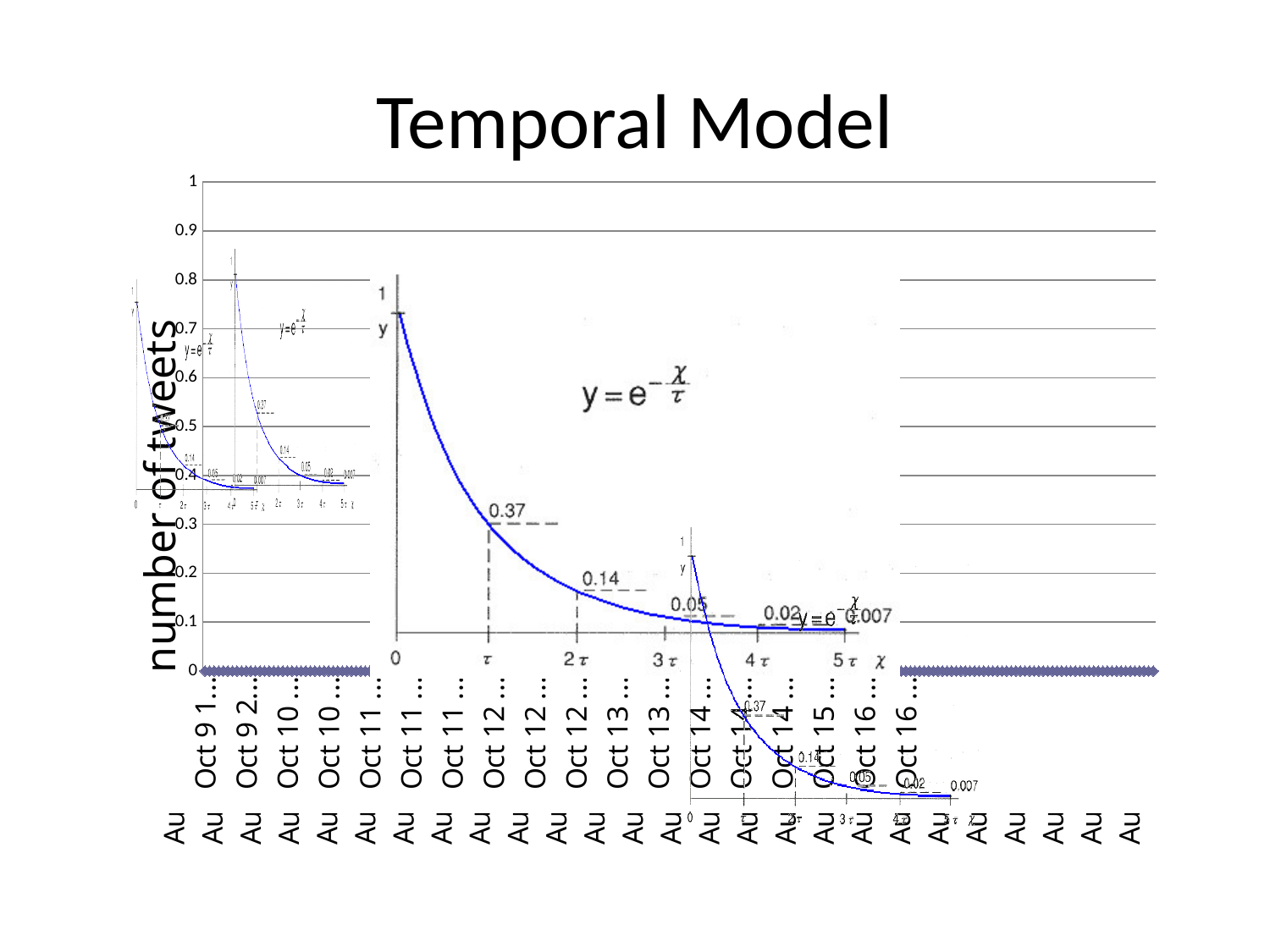
In the large exponential decay curve image, what is the difference between the values labelled at τ and 2τ? 0.23 In the large exponential decay curve image overlaid on the chart, what value is labelled at x = τ? 0.37 In the large exponential decay curve image overlaid on the chart, what value is labelled at x = 2τ? 0.14 In the large exponential decay curve image overlaid on the chart, what value is labelled at x = 3τ? 0.05 What is the lowest tick value shown on the vertical axis of the chart? 0 In the large exponential decay curve image, does the curve rise or fall as x increases? fall In the large exponential decay curve image overlaid on the chart, what value is labelled at x = 5τ? 0.007 In the large exponential decay curve image overlaid on the chart, what value is labelled at x = 4τ? 0.02 What is the title of the slide containing the chart? Temporal Model What is the highest tick value shown on the vertical axis of the chart? 1 What is the label on the vertical axis of the chart? number of tweets In the large exponential decay curve image, which labelled value is larger: the one at 3τ or the one at 4τ? 3τ (0.05)